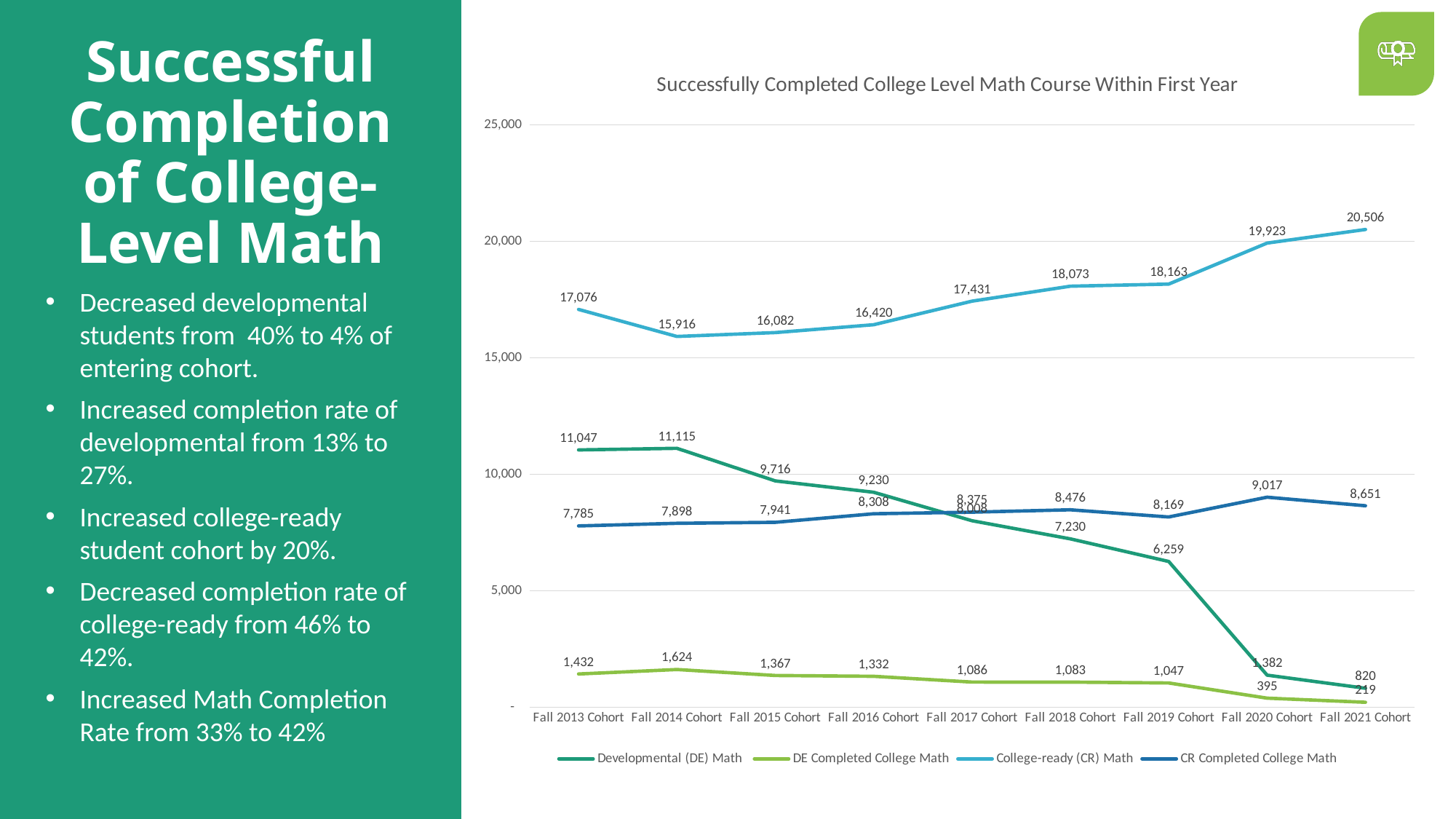
What is the value for College-ready (CR) Math for the Fall 2021 Cohort? 20,506 Which is larger for Developmental (DE) Math: the Fall 2013 Cohort or the Fall 2014 Cohort? Fall 2014 Cohort How many series does the legend list? 4 What kind of chart is shown on the slide? line chart Which cohort has the highest value for College-ready (CR) Math? Fall 2021 Cohort What is the value for DE Completed College Math for the Fall 2021 Cohort? 219 How many cohorts are shown on the x axis? 9 Is the value for College-ready (CR) Math for the Fall 2019 Cohort greater or less than 15,000? greater What is the value for Developmental (DE) Math for the Fall 2013 Cohort? 11,047 Which cohort has the highest value for DE Completed College Math? Fall 2014 Cohort Which cohort has the lowest value for College-ready (CR) Math? Fall 2014 Cohort What is the difference between the College-ready (CR) Math values for the Fall 2021 Cohort and the Fall 2020 Cohort? 583